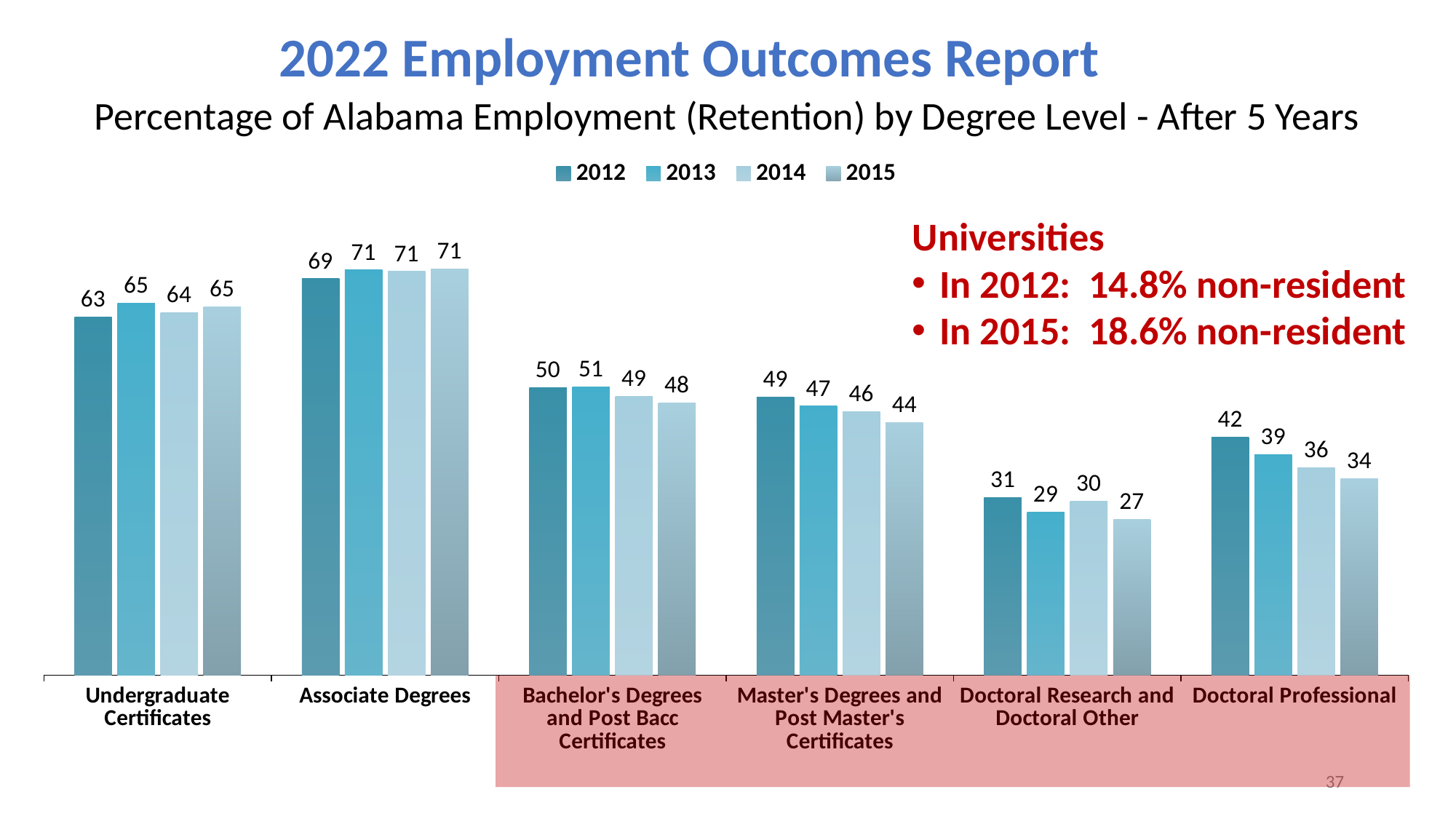
What kind of chart is shown on the slide? Bar chart Do the values for Master's Degrees and Post Master's Certificates rise or fall from 2012 to 2015? Fall Which degree level has the highest 2015 value? Associate Degrees What is the 2012 value for Associate Degrees? 69 What is the 2015 value for Doctoral Research and Doctoral Other? 27 What is the difference between the 2012 and 2015 values for Doctoral Professional? 8 How many series does the legend list? 4 How many degree-level categories are shown on the x axis? 6 What is the 2013 value for Doctoral Professional? 39 Which is larger: the 2013 value for Undergraduate Certificates or the 2013 value for Bachelor's Degrees and Post Bacc Certificates? Undergraduate Certificates What is the 2014 value for Master's Degrees and Post Master's Certificates? 46 Which degree level has the lowest 2012 value? Doctoral Research and Doctoral Other